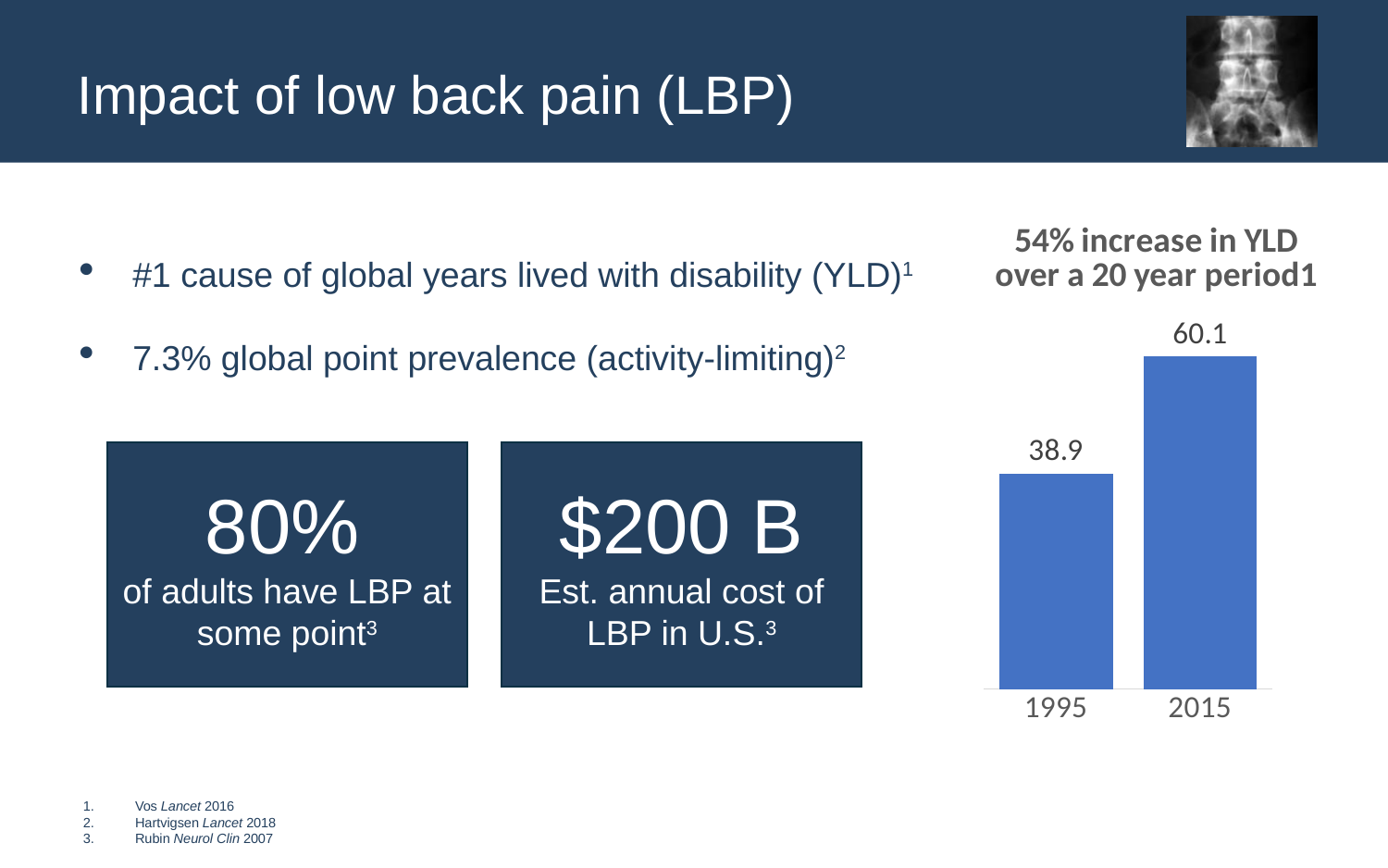
Which year has the lower value in the chart? 1995 What is the difference between the 2015 and 1995 values in the chart? 21.2 How many bars are shown in the chart? 2 What is the value for 1995 in the chart? 38.9 What is the title of the chart? 54% increase in YLD over a 20 year period1 What is the value for 2015 in the chart? 60.1 Do the values rise or fall from 1995 to 2015? rise What colour are the bars in the chart? blue Which year has the higher value in the chart? 2015 Is the value for 2015 larger or smaller than the value for 1995? larger What kind of chart is shown on the slide? bar chart